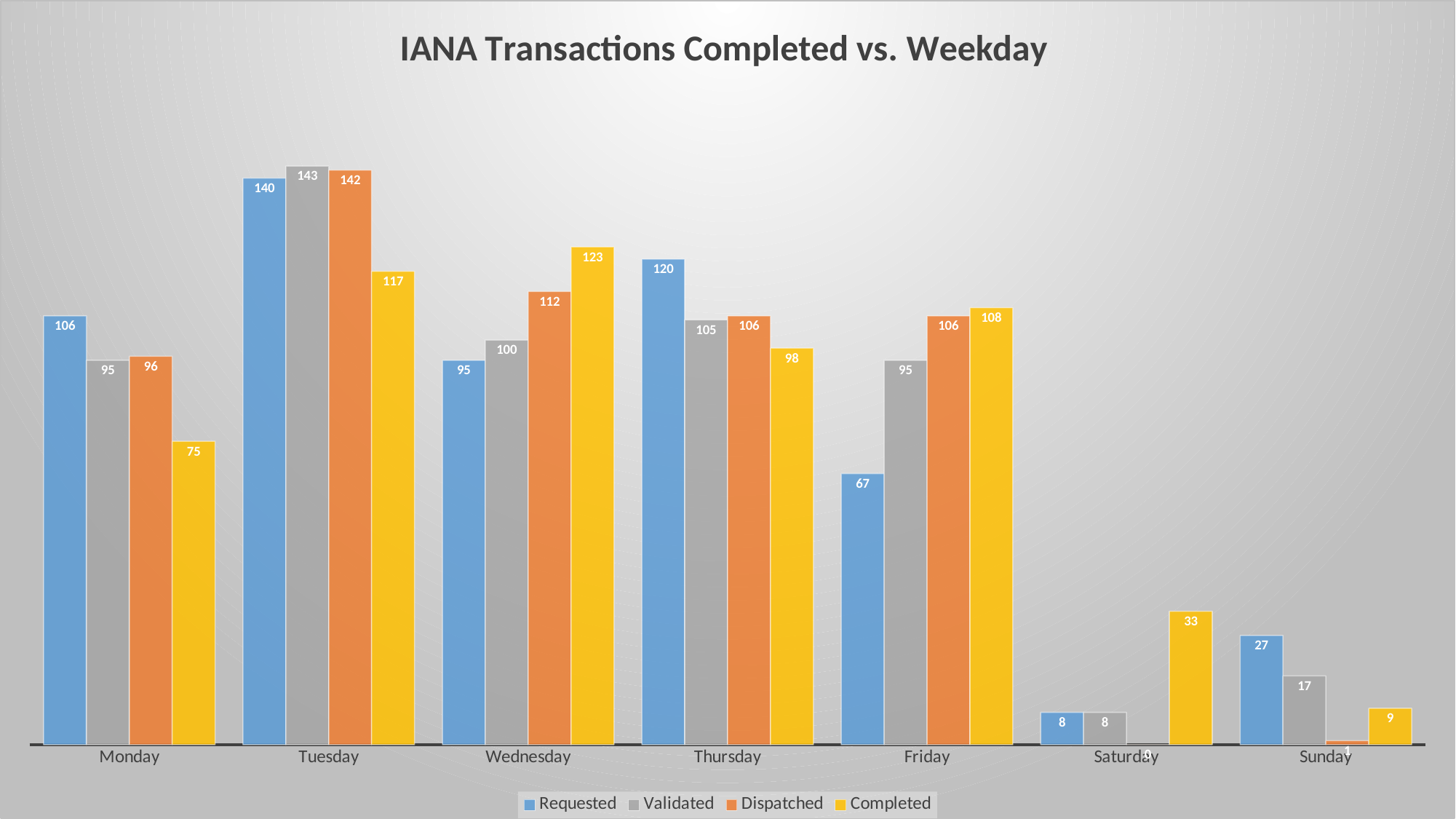
Which is larger on Thursday, the Requested value or the Completed value? Requested What is the title of the chart? IANA Transactions Completed vs. Weekday Which weekday has the lowest Completed value? Sunday What is the Completed value for Wednesday? 123 Which weekday has the highest Requested value? Tuesday What is the difference between the Requested and Completed values for Monday? 31 What is the Completed value for Saturday? 33 How many series does the legend list? 4 What is the Requested value for Friday? 67 What is the Validated value for Tuesday? 143 How many weekday categories are shown on the x axis? 7 What type of chart is shown on the slide? bar chart